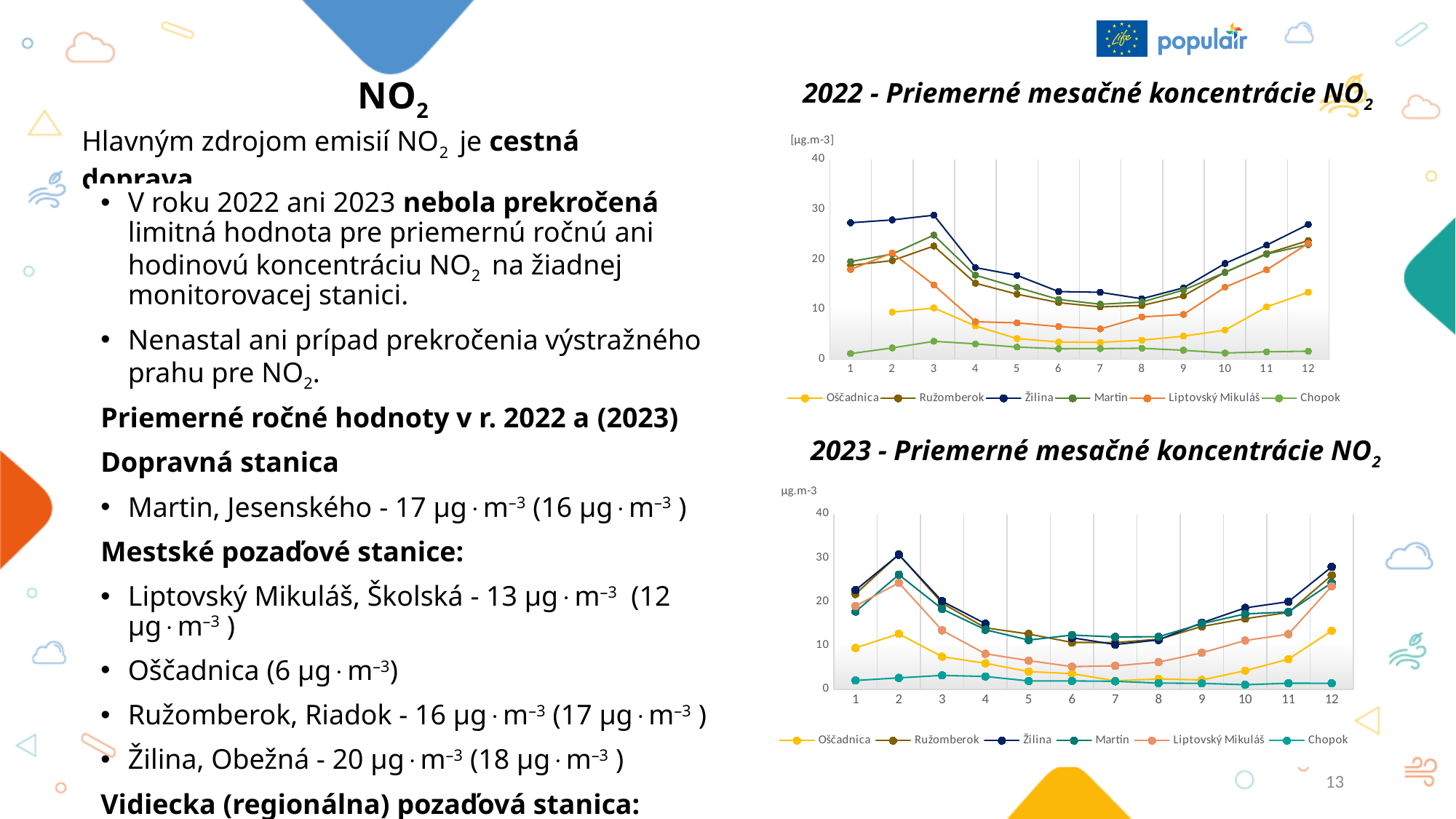
What type of chart is the 2022 - Priemerné mesačné koncentrácie NO2 chart? line chart How many points along the x axis does the 2022 - Priemerné mesačné koncentrácie NO2 chart have? 12 In the 2022 - Priemerné mesačné koncentrácie NO2 chart, does the Žilina series rise or fall from month 3 to month 8? fall In the 2022 - Priemerné mesačné koncentrácie NO2 chart, is the value for Žilina in month 1 greater or less than 20? greater In the 2022 - Priemerné mesačné koncentrácie NO2 chart, which station has the lowest value in month 12? Chopok In the 2023 - Priemerné mesačné koncentrácie NO2 chart, is the value for Oščadnica in month 12 greater or less than 10? greater In the 2023 - Priemerné mesačné koncentrácie NO2 chart, which is larger in month 2, Liptovský Mikuláš or Oščadnica? Liptovský Mikuláš In the 2022 - Priemerné mesačné koncentrácie NO2 chart, which station has the highest value in month 3? Žilina How many series does the legend of the 2023 - Priemerné mesačné koncentrácie NO2 chart list? 6 What unit is shown on the y axis of the 2022 - Priemerné mesačné koncentrácie NO2 chart? [µg.m-3]